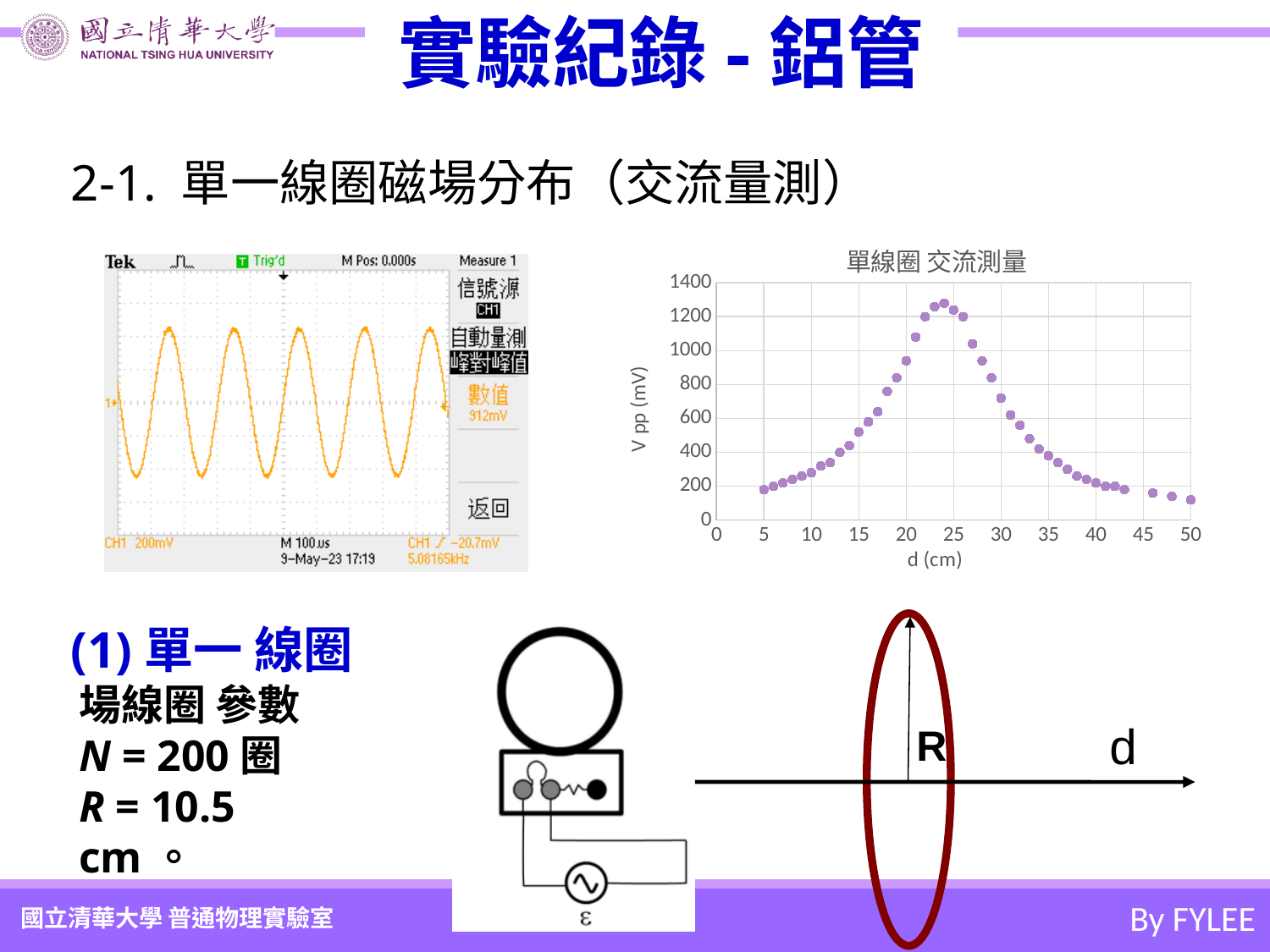
In the '單線圈 交流測量' chart, do the values rise or fall as d increases from 25 cm to 50 cm? fall In the '單線圈 交流測量' chart, is the peak value greater or less than 1200? greater In the '單線圈 交流測量' chart, which is larger, the value at d = 20 cm or the value at d = 30 cm? d = 20 cm In the '單線圈 交流測量' chart, is the value at d = 15 cm greater or less than 600? less What is the title of the chart on the right side of the slide? 單線圈 交流測量 In the '單線圈 交流測量' chart, what is the label of the y axis? V pp (mV) In the '單線圈 交流測量' chart, is the value at d = 50 cm greater or less than 200? less What kind of chart is the '單線圈 交流測量' chart? scatter chart In the '單線圈 交流測量' chart, between which two x-axis ticks does the peak of the data lie? 20 and 25